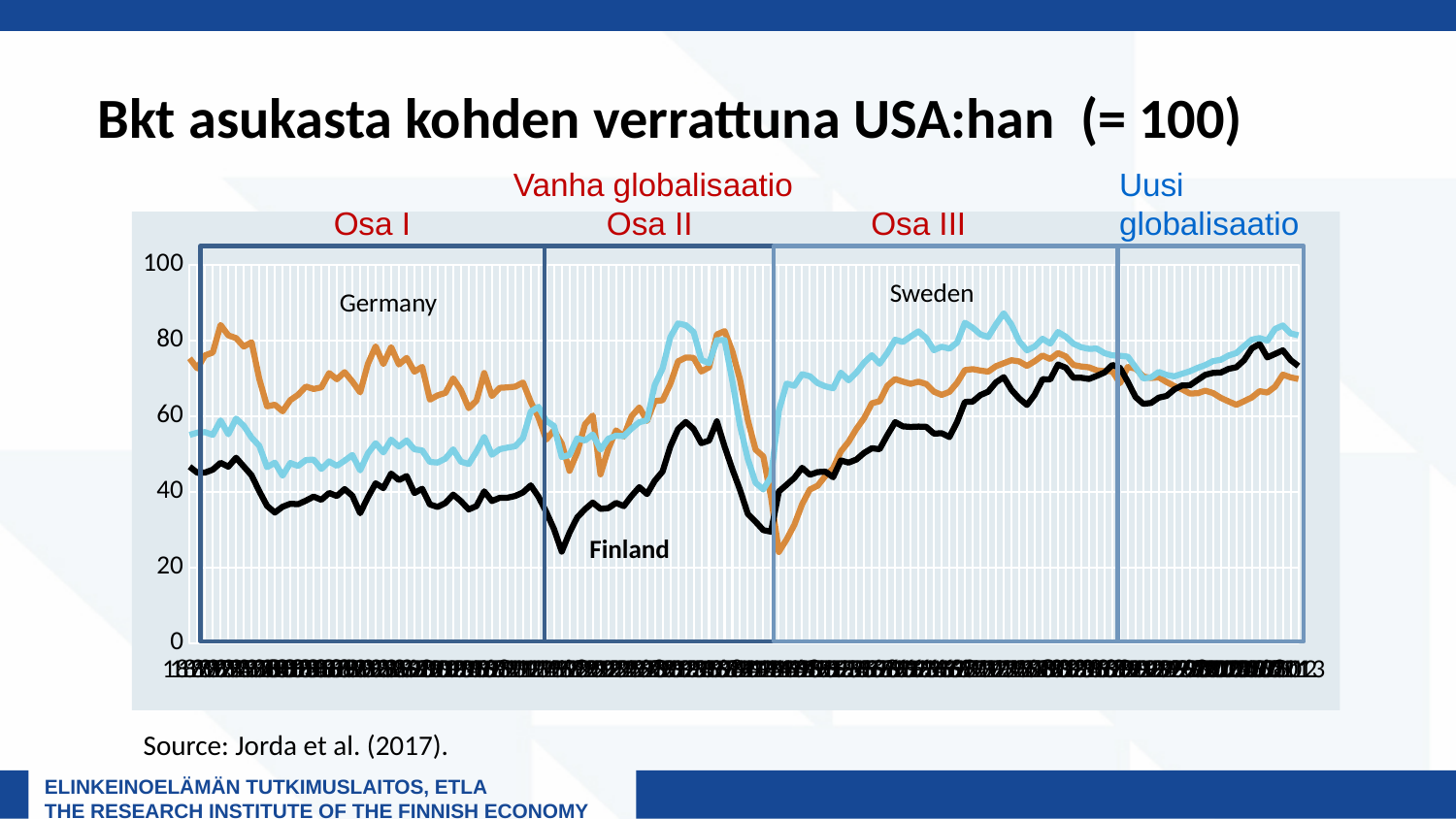
How many labelled periods (Osa I, Osa II, Osa III, Uusi globalisaatio) are marked on the chart? 4 Is Germany's lowest value at the start of the Osa III period greater or less than 40? less Which countries are plotted in the chart? Germany, Sweden, Finland How many countries' series are plotted in the chart? 3 At the start of the chart, which is larger, the value for Germany or the value for Finland? Germany Which country's line is the highest at the very start of the chart? Germany Which country's line is the lowest for most of the Osa I period? Finland Does Finland's line rise or fall over the Osa III period? rise What kind of chart is shown on the slide? line chart At the start of the chart, is the value for Germany greater or less than 60? greater What is the title of the chart on the slide? Bkt asukasta kohden verrattuna USA:han (= 100) Is Finland's lowest value in the Osa II period greater or less than 40? less